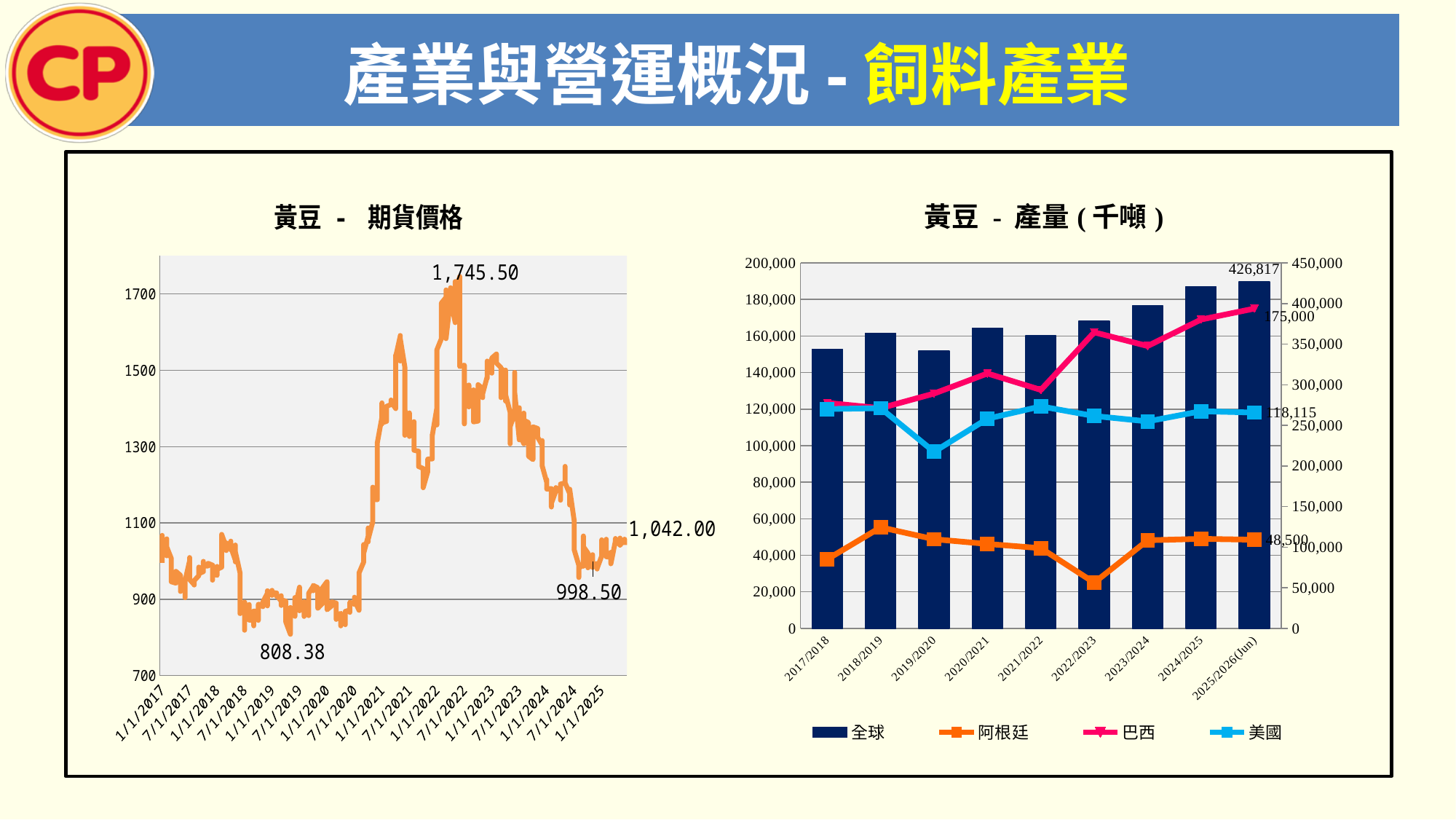
How many series does the legend of the right chart (黃豆 - 產量) list? 4 On the left chart (黃豆 - 期貨價格), what is the lowest labelled price? 808.38 On the left chart (黃豆 - 期貨價格), what is the most recent labelled price at the right end of the line? 1,042.00 On the right chart (黃豆 - 產量), do the 全球 bars generally rise or fall from 2017/2018 to 2025/2026(Jun)? rise On the right chart (黃豆 - 產量), what is the labelled value of 全球 for 2025/2026(Jun)? 426,817 On the right chart (黃豆 - 產量), is the value for 阿根廷 in 2022/2023 greater or less than 40,000? less On the left chart (黃豆 - 期貨價格), what is the highest labelled price? 1,745.50 On the right chart (黃豆 - 產量), what is the labelled value of 巴西 for 2025/2026(Jun)? 175,000 On the right chart (黃豆 - 產量), what is the difference between the 巴西 and 美國 values for 2025/2026(Jun)? 56,885 How many crop-year categories are shown on the x axis of the right chart (黃豆 - 產量)? 9 On the right chart (黃豆 - 產量), what is the labelled value of 阿根廷 for 2025/2026(Jun)? 48,500 What kind of chart is the left chart titled 黃豆 - 期貨價格? line chart